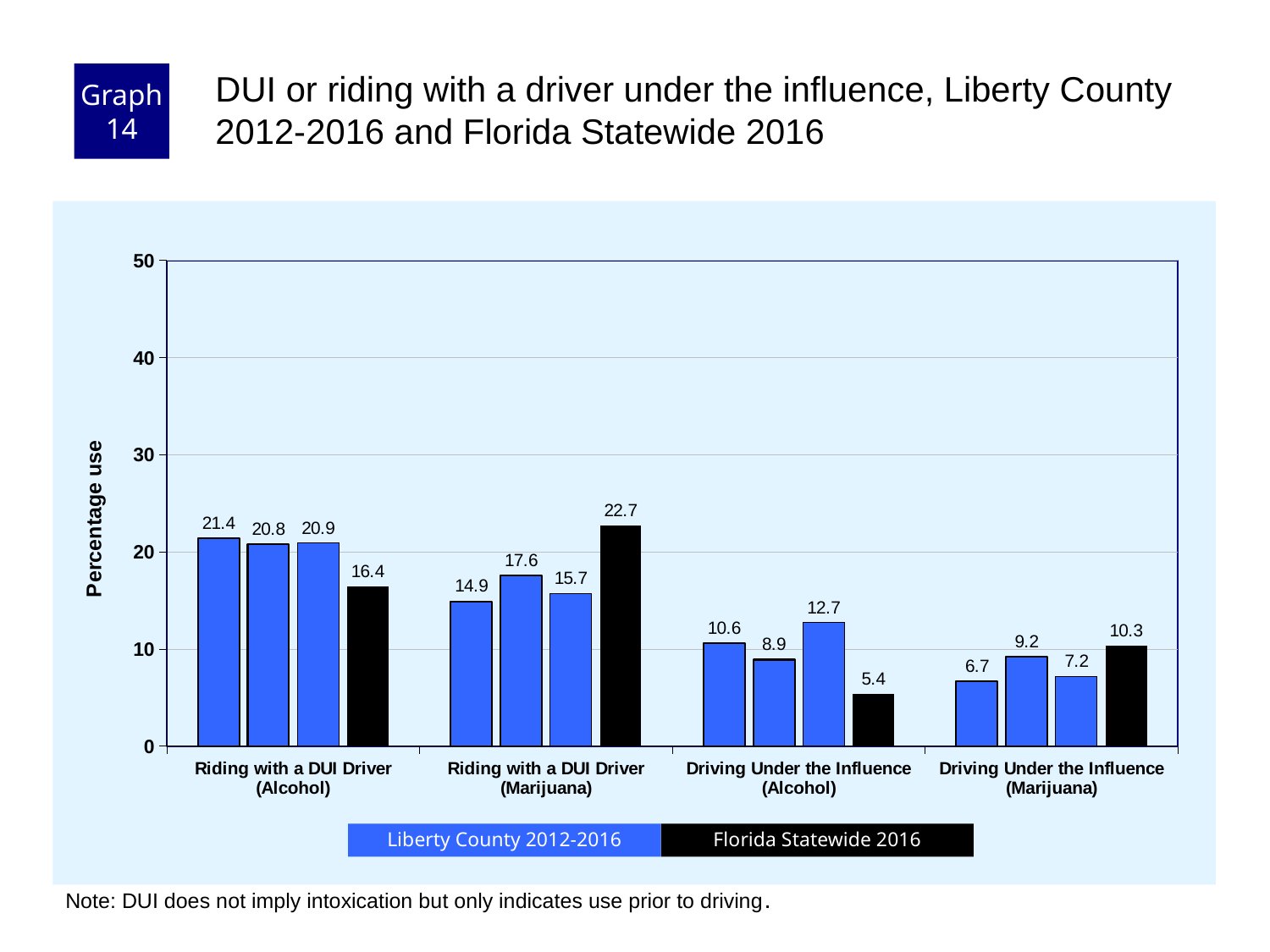
Which category has the lowest Florida Statewide 2016 value? Driving Under the Influence (Alcohol) What is the Florida Statewide 2016 value for Driving Under the Influence (Alcohol)? 5.4 How many categories are shown on the x axis? 4 What kind of chart is shown on the slide? bar chart For Driving Under the Influence (Marijuana), which is larger: the Florida Statewide 2016 bar or the leftmost Liberty County 2012-2016 bar? Florida Statewide 2016 What is the difference between the Florida Statewide 2016 values for Riding with a DUI Driver (Marijuana) and Riding with a DUI Driver (Alcohol)? 6.3 What is the value of the leftmost Liberty County 2012-2016 bar for Riding with a DUI Driver (Alcohol)? 21.4 How many series does the legend list? 2 Is the Florida Statewide 2016 value for Driving Under the Influence (Alcohol) greater or less than 10? less Which category has the highest Florida Statewide 2016 value? Riding with a DUI Driver (Marijuana) What is the Florida Statewide 2016 value for Riding with a DUI Driver (Marijuana)? 22.7 What is the Florida Statewide 2016 value for Riding with a DUI Driver (Alcohol)? 16.4